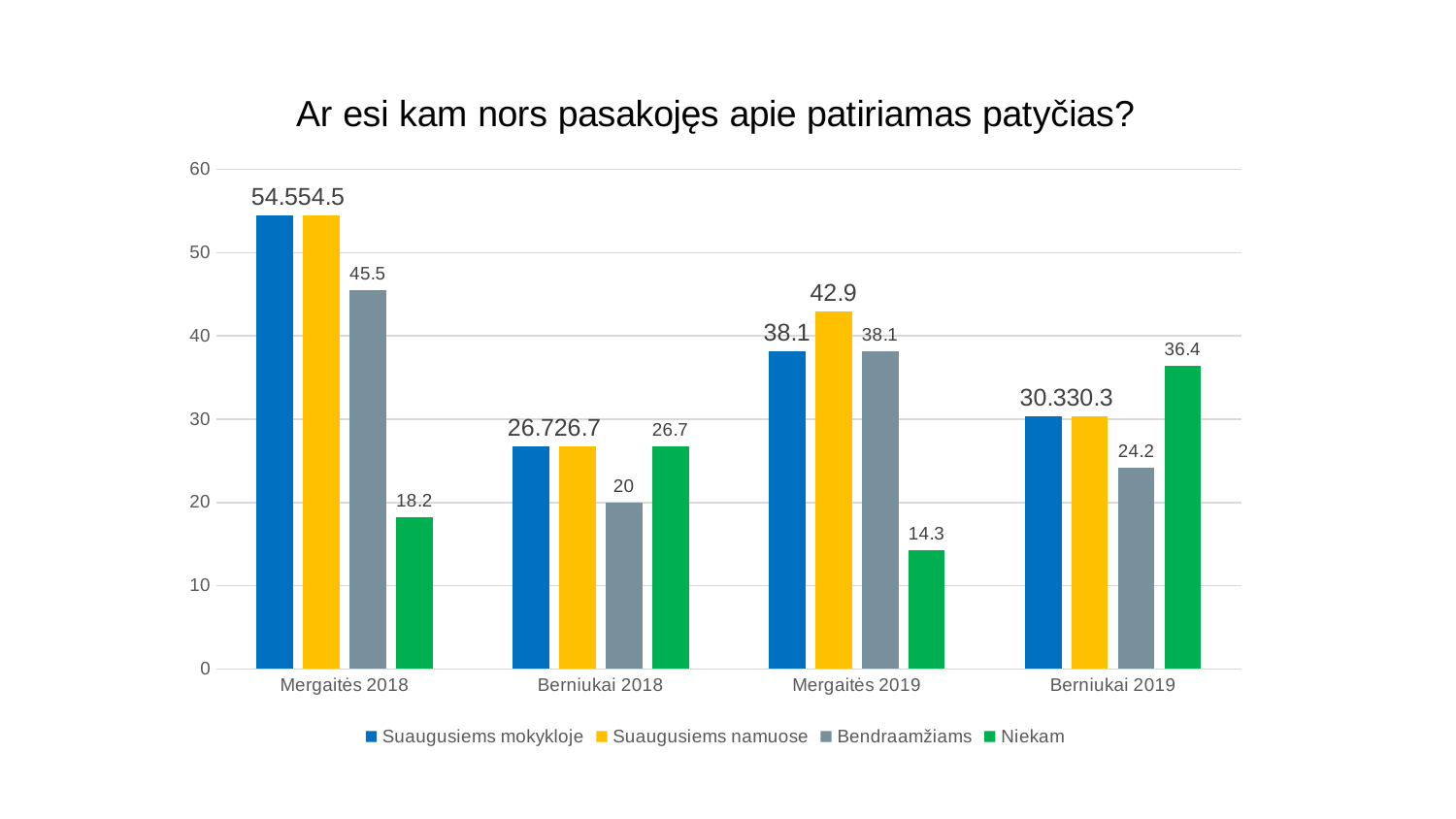
How many category groups are shown on the x axis? 4 What is the value for Bendraamžiams in the Berniukai 2018 group? 20 Is the value for Suaugusiems mokykloje in the Mergaitės 2018 group greater or less than 50? greater What is the value for Niekam in the Mergaitės 2019 group? 14.3 What is the value for Suaugusiems namuose in the Berniukai 2019 group? 30.3 What is the difference between the Suaugusiems namuose value and the Niekam value in the Mergaitės 2019 group? 28.6 What is the value for Bendraamžiams in the Mergaitės 2018 group? 45.5 What type of chart is shown on the slide? bar chart How many series does the legend list? 4 Which is larger: the Niekam value for Berniukai 2019 or the Niekam value for Berniukai 2018? Berniukai 2019 Which series has the highest value in the Berniukai 2019 group? Niekam Which series has the lowest value in the Mergaitės 2018 group? Niekam